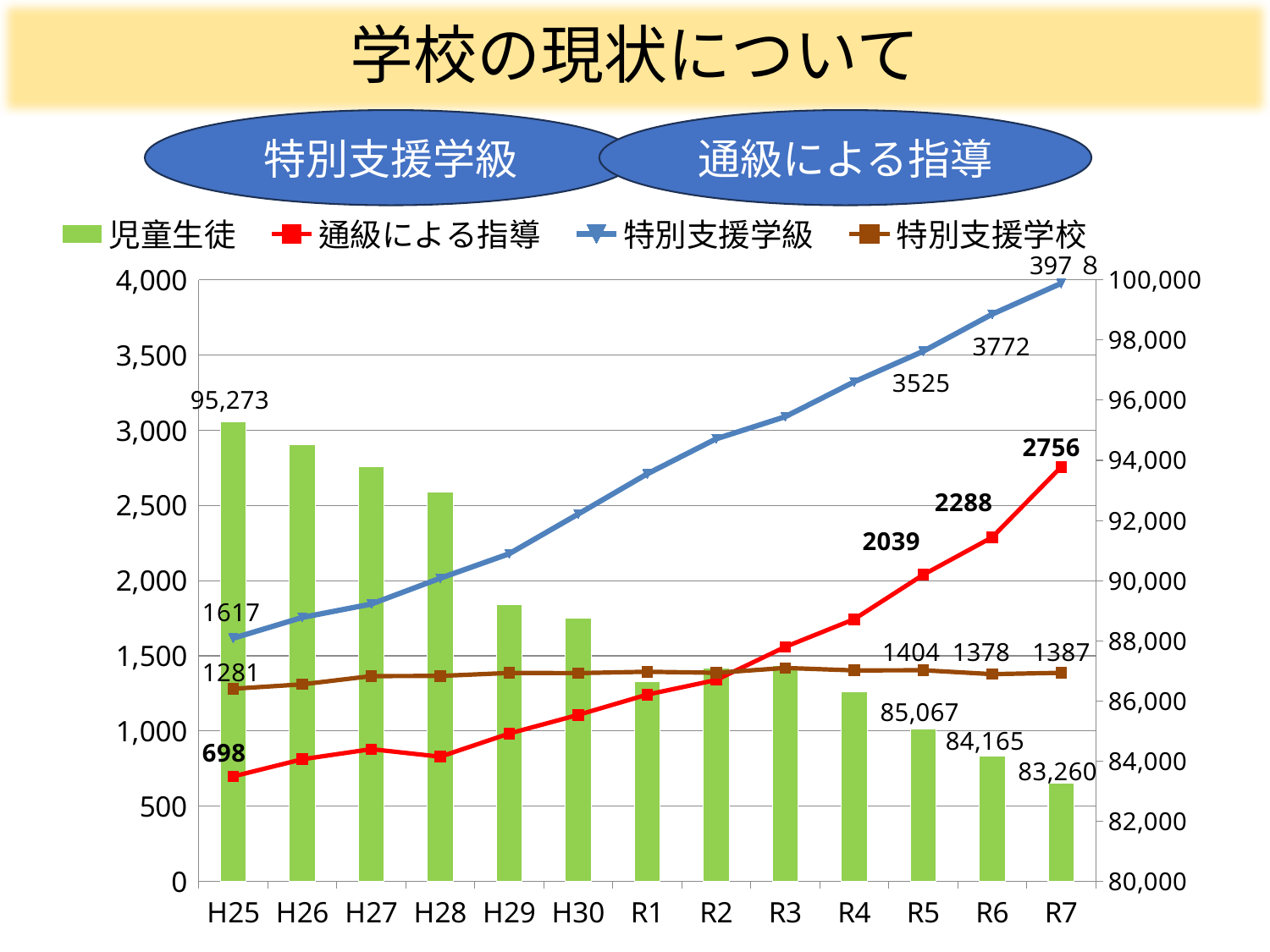
How many years are shown on the x axis? 13 What is the value of 通級による指導 for R7? 2756 At R7, which is larger: 特別支援学級 or 通級による指導? 特別支援学級 By how much did 通級による指導 increase from H25 to R7? 2058 What is the difference between the 児童生徒 values for R6 and R7? 905 What is the value of 児童生徒 for H25? 95,273 What kind of chart is this? Combined bar and line chart Is the value for 通級による指導 at R1 greater or less than 1,500? less Do the 児童生徒 bars rise or fall from H25 to R7? Fall What is the value of 特別支援学校 for R6? 1378 What is the value of 特別支援学級 for H25? 1617 How many series does the legend list? 4